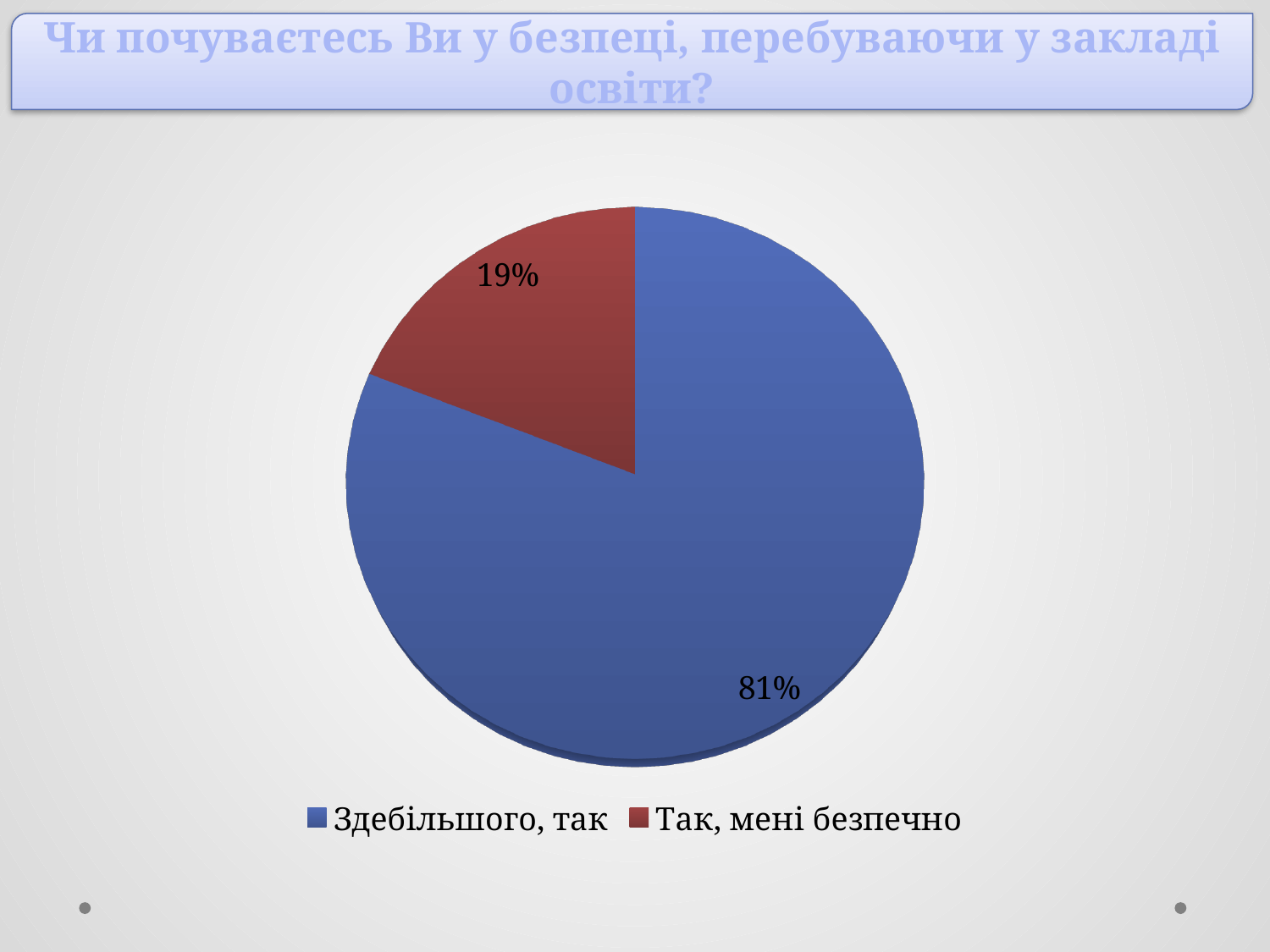
How many categories are shown in the pie chart? 2 What is the title of the slide? Чи почуваєтесь Ви у безпеці, перебуваючи у закладі освіти? How many entries does the legend list? 2 What share of the pie does "Здебільшого, так" represent? 81% Which category has the smallest slice of the pie? Так, мені безпечно Which is larger: the slice for "Здебільшого, так" or the slice for "Так, мені безпечно"? Здебільшого, так What kind of chart is shown on the slide? Pie chart What colour is the slice for "Так, мені безпечно"? Red What is the difference in percentage points between the "Здебільшого, так" slice and the "Так, мені безпечно" slice? 62 Which category has the largest slice of the pie? Здебільшого, так What share of the pie does "Так, мені безпечно" represent? 19%